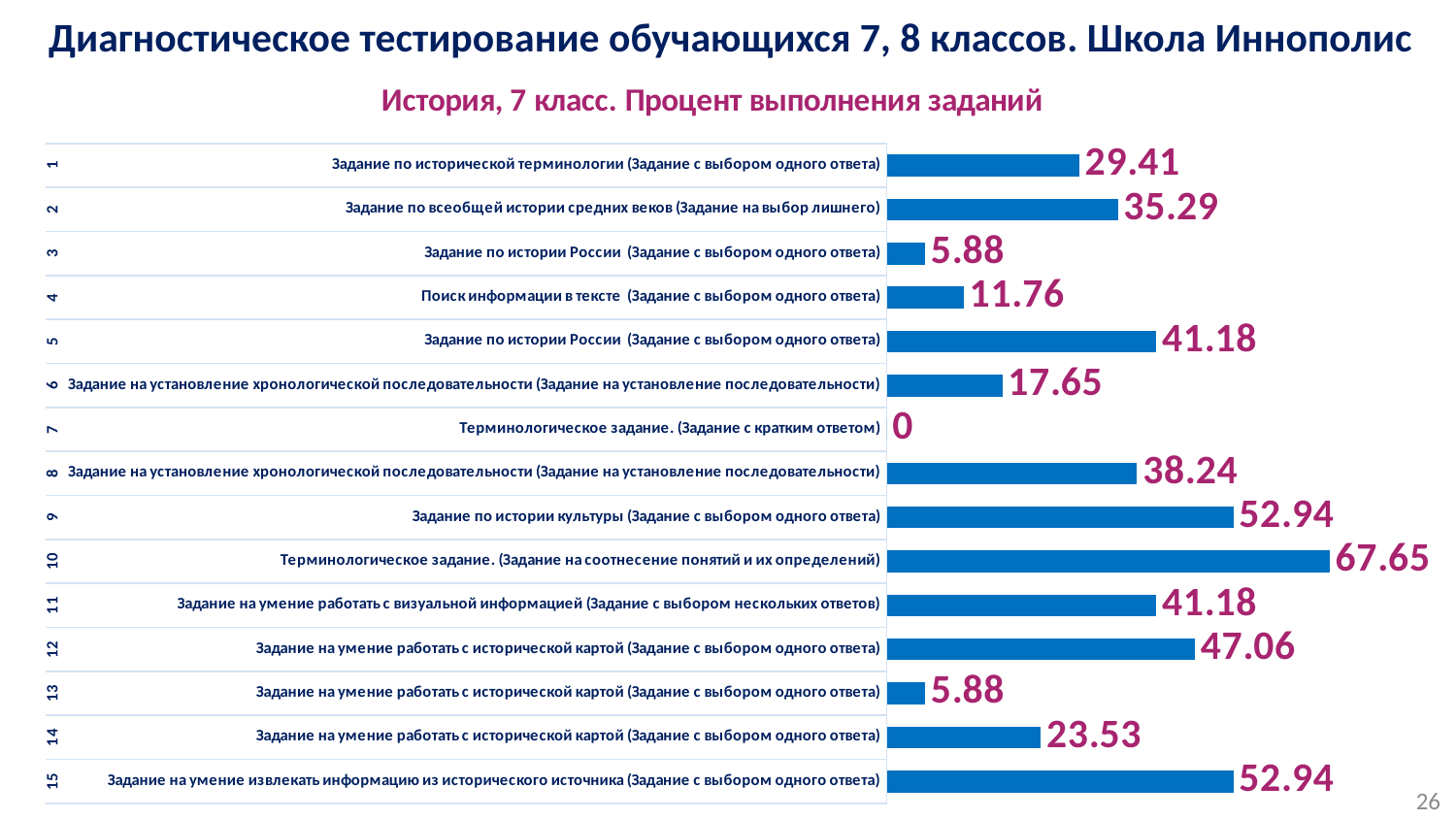
What is the value for task 1 (Задание по исторической терминологии)? 29.41 Which task has the lowest value? Task 7 (Терминологическое задание. Задание с кратким ответом) What kind of chart is shown on the slide? Bar chart What is the difference between the value for task 2 and the value for task 1? 5.88 What is the value for task 14 (Задание на умение работать с исторической картой)? 23.53 What is the difference between the value for task 10 and the value for task 9? 14.71 Which task has the highest value? Task 10 (Терминологическое задание. Задание на соотнесение понятий и их определений) What is the value for task 7 (Терминологическое задание. Задание с кратким ответом)? 0 How many tasks (bars) are shown in the chart? 15 What is the value for task 10 (Терминологическое задание. Задание на соотнесение понятий и их определений)? 67.65 What is the subtitle of the chart? История, 7 класс. Процент выполнения заданий Which is larger, the value for task 12 or the value for task 11? Task 12